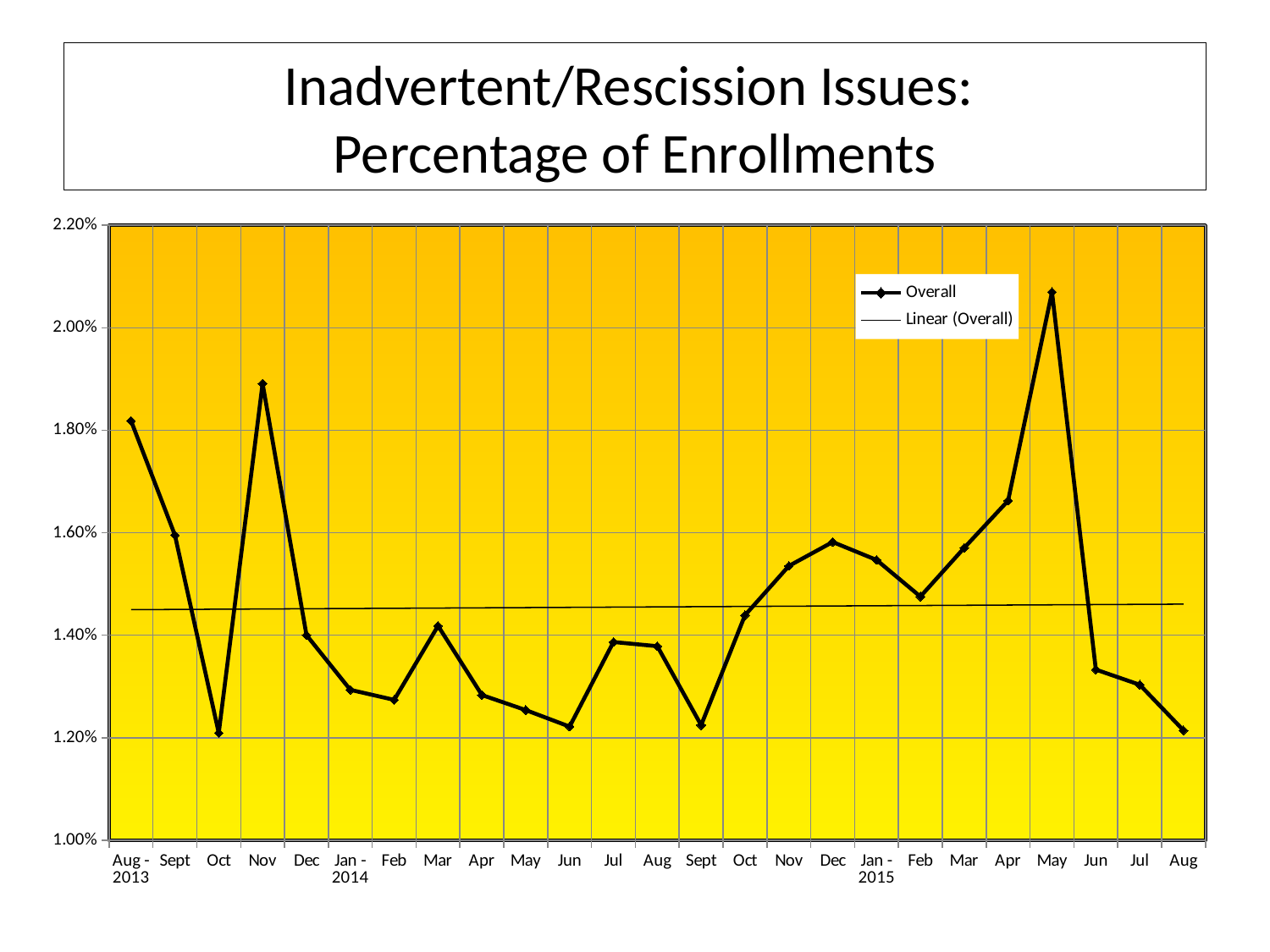
Does the Overall line rise or fall from May 2015 to Aug 2015? fall How many monthly data points are plotted on the Overall line? 25 Is the Overall value for May 2015 greater or less than 2.00%? greater What kind of chart is shown on the slide? line chart How many entries does the legend list? 2 Is the Overall value for Nov 2013 greater or less than 1.80%? greater Is the Overall value for Jun 2014 greater or less than 1.40%? less Which is larger, the Overall value for Aug 2013 or for Sept 2013? Aug 2013 What is the title of the chart? Inadvertent/Rescission Issues: Percentage of Enrollments Which is larger, the Overall value for Nov 2013 or for Dec 2013? Nov 2013 Which month has the highest Overall value? May 2015